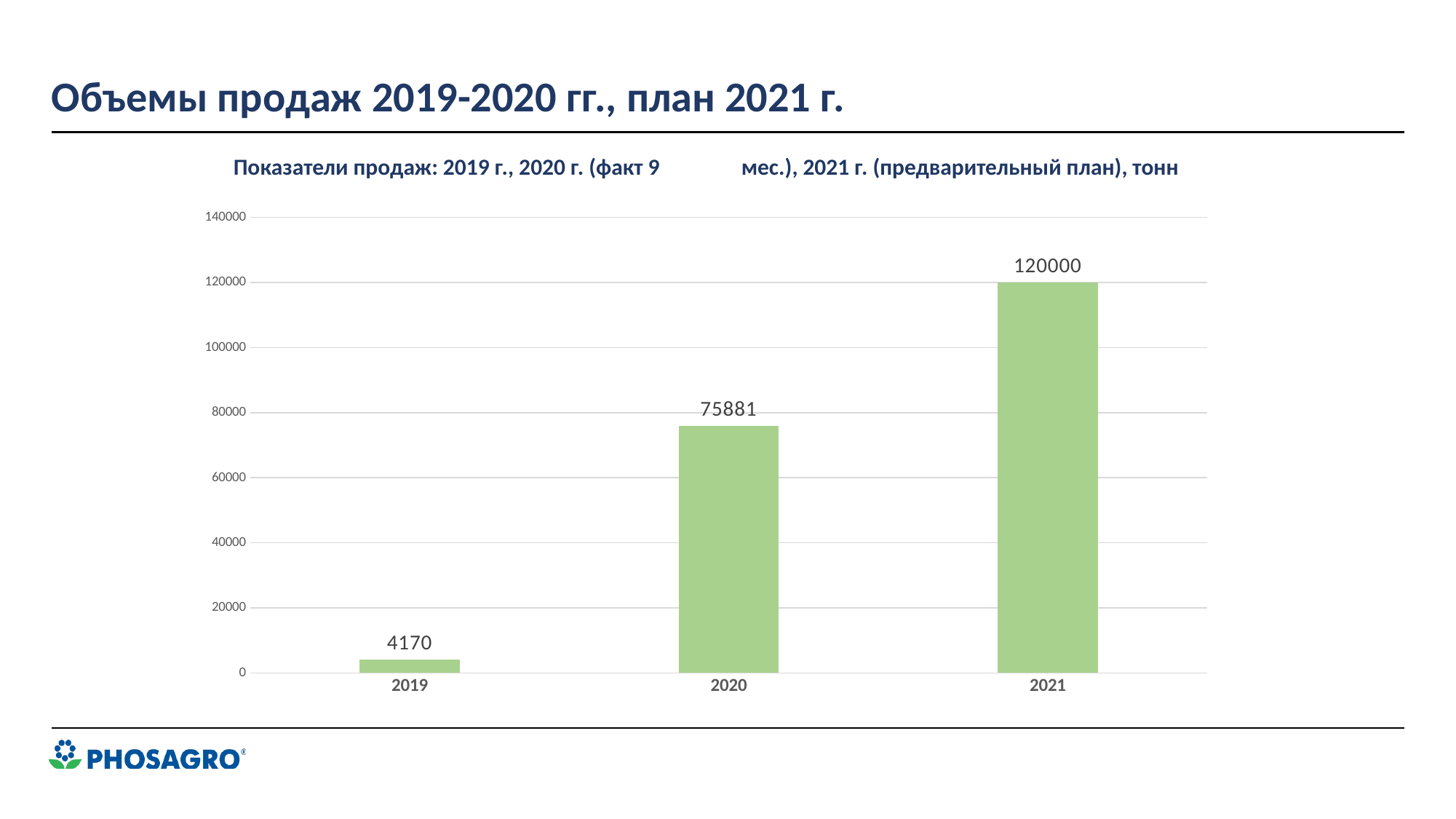
What is the value for 2020? 75881 How many years are shown on the x axis? 3 What is the value for 2019? 4170 Which year has the highest value? 2021 What kind of chart is shown on the slide? bar chart Do the values rise or fall from 2019 to 2021? rise What is the difference between the values for 2021 and 2020? 44119 What is the value for 2021? 120000 Which is larger, the value for 2020 or the value for 2019? 2020 Is the value for 2020 greater or less than 80000? less What is the difference between the values for 2020 and 2019? 71711 Which year has the lowest value? 2019